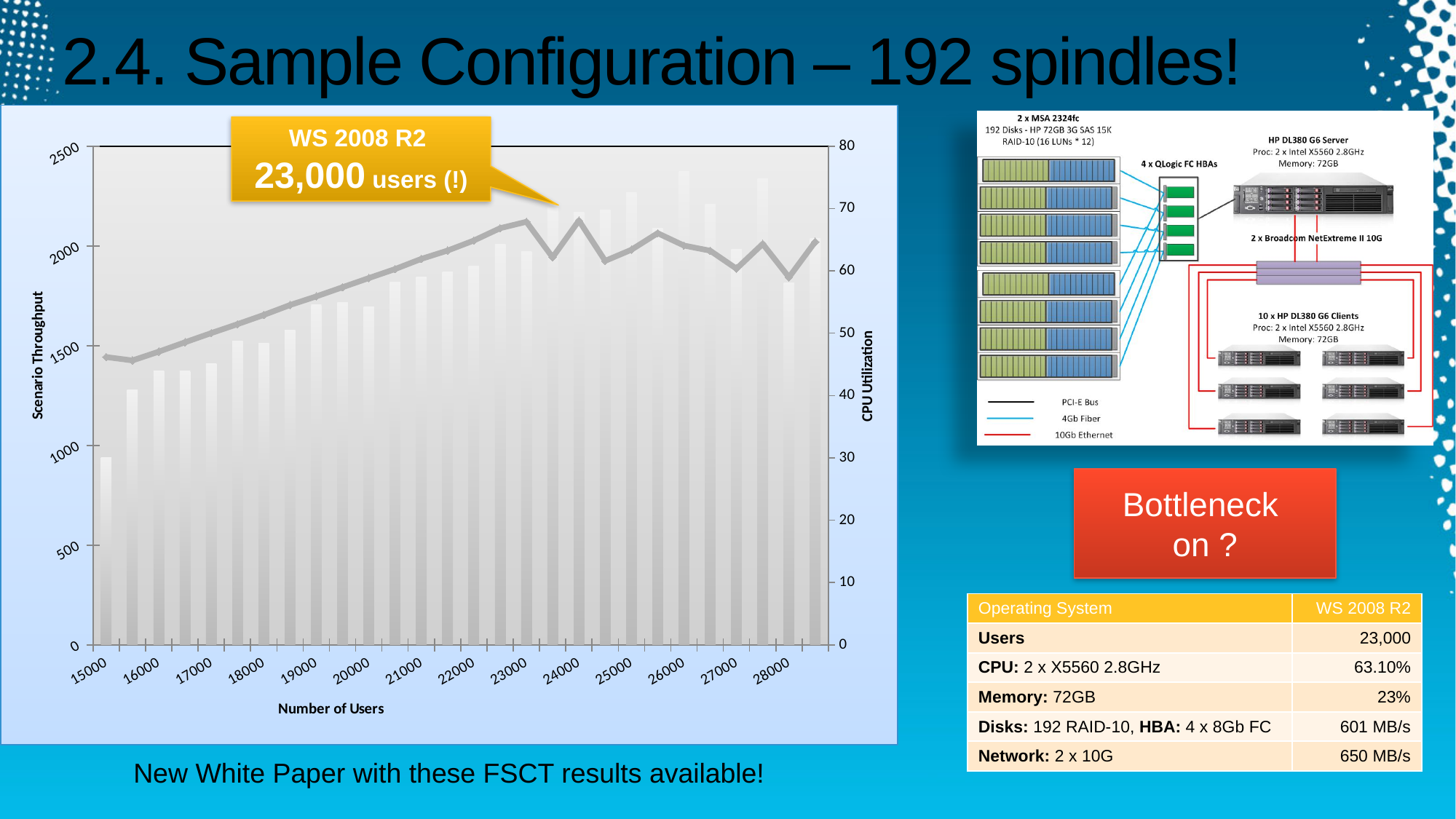
How many user-count labels are shown on the x axis of the chart? 14 Is the CPU Utilization value at 15000 users greater or less than 50? less What is the label of the x axis of the chart? Number of Users Which is larger, the Scenario Throughput bar at 15000 users or at 20000 users? 20000 users What is the label of the right-hand vertical axis of the chart? CPU Utilization What kind of chart is shown on the slide? Combined bar and line chart Which is larger, the CPU Utilization at 15000 users or at 23000 users? 23000 users Is the CPU Utilization value at 23000 users greater or less than 60? greater Does the CPU Utilization line rise or fall between 15000 and 23000 users? rise